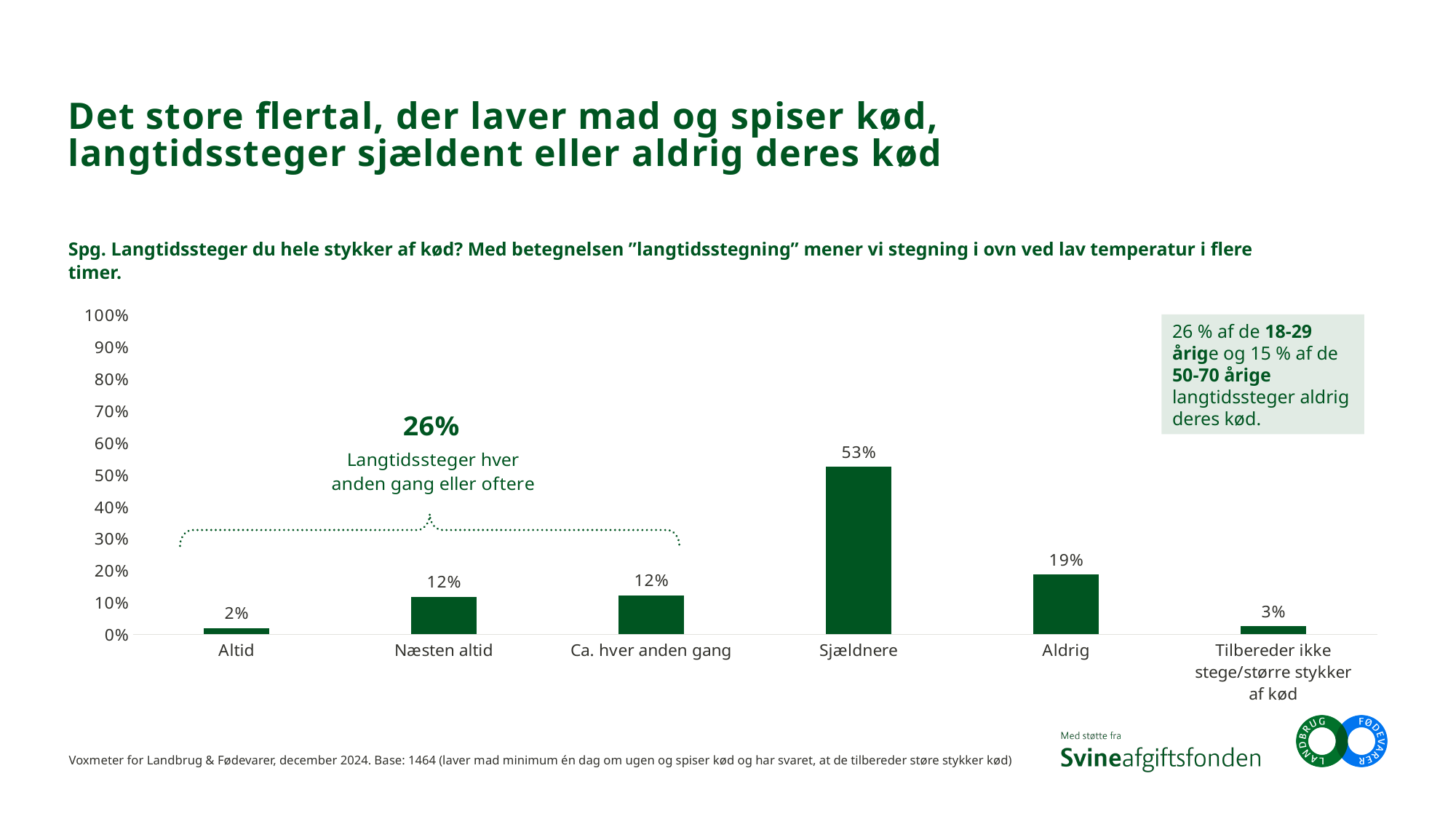
What kind of chart is shown on the slide? Bar chart What is the difference between the values for Sjældnere and Aldrig? 34% Which category has the lowest value? Altid What is the value for Sjældnere? 53% What is the value for Tilbereder ikke stege/større stykker af kød? 3% What percentage does the annotation above the bracket say long-roast every other time or more often? 26% Which is larger, the value for Aldrig or the value for Næsten altid? Aldrig What is the value for Aldrig? 19% What is the value for Altid? 2% How many categories are shown on the x axis? 6 Which category has the highest value? Sjældnere Is the value for Sjældnere greater or less than 50%? greater